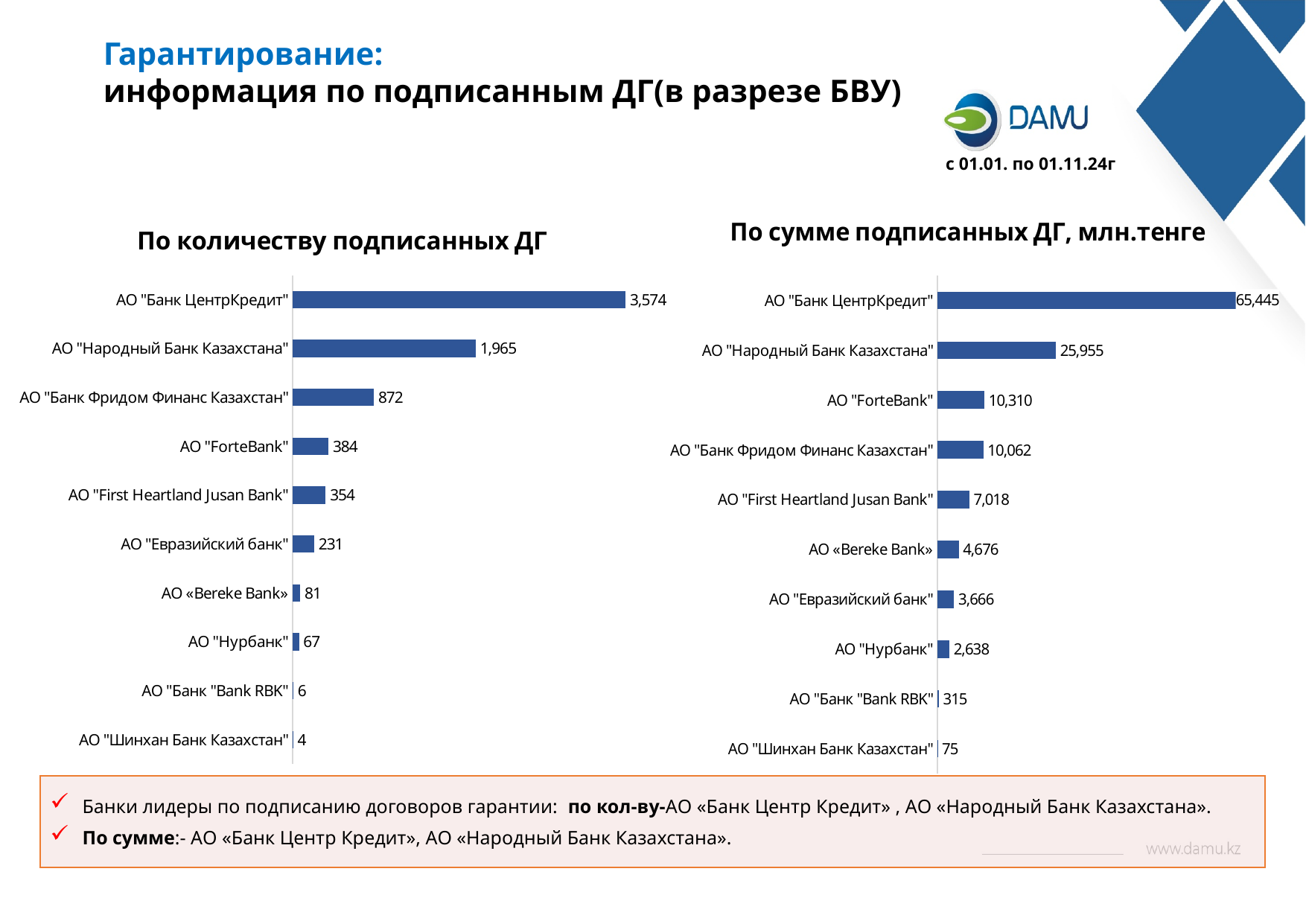
In the chart "По количеству подписанных ДГ", what is the difference between АО "Народный Банк Казахстана" and АО "Банк Фридом Финанс Казахстан"? 1,093 What type of chart is "По сумме подписанных ДГ, млн.тенге"? Bar chart In the chart "По количеству подписанных ДГ", what is the value for АО "Банк ЦентрКредит"? 3,574 In the chart "По сумме подписанных ДГ, млн.тенге", what is the difference between АО "Банк ЦентрКредит" and АО "Народный Банк Казахстана"? 39,490 In the chart "По количеству подписанных ДГ", what is the value for АО "Банк "Bank RBK"? 6 In the chart "По сумме подписанных ДГ, млн.тенге", what is the value for АО «Bereke Bank»? 4,676 In the chart "По количеству подписанных ДГ", which bank has the lowest value? АО "Шинхан Банк Казахстан" In the chart "По сумме подписанных ДГ, млн.тенге", which is larger: АО "ForteBank" or АО "Банк Фридом Финанс Казахстан"? АО "ForteBank" In the chart "По количеству подписанных ДГ", how many banks are shown? 10 In the chart "По количеству подписанных ДГ", what is the value for АО "ForteBank"? 384 In the chart "По сумме подписанных ДГ, млн.тенге", which bank has the highest value? АО "Банк ЦентрКредит" In the chart "По сумме подписанных ДГ, млн.тенге", what is the value for АО "Народный Банк Казахстана"? 25,955